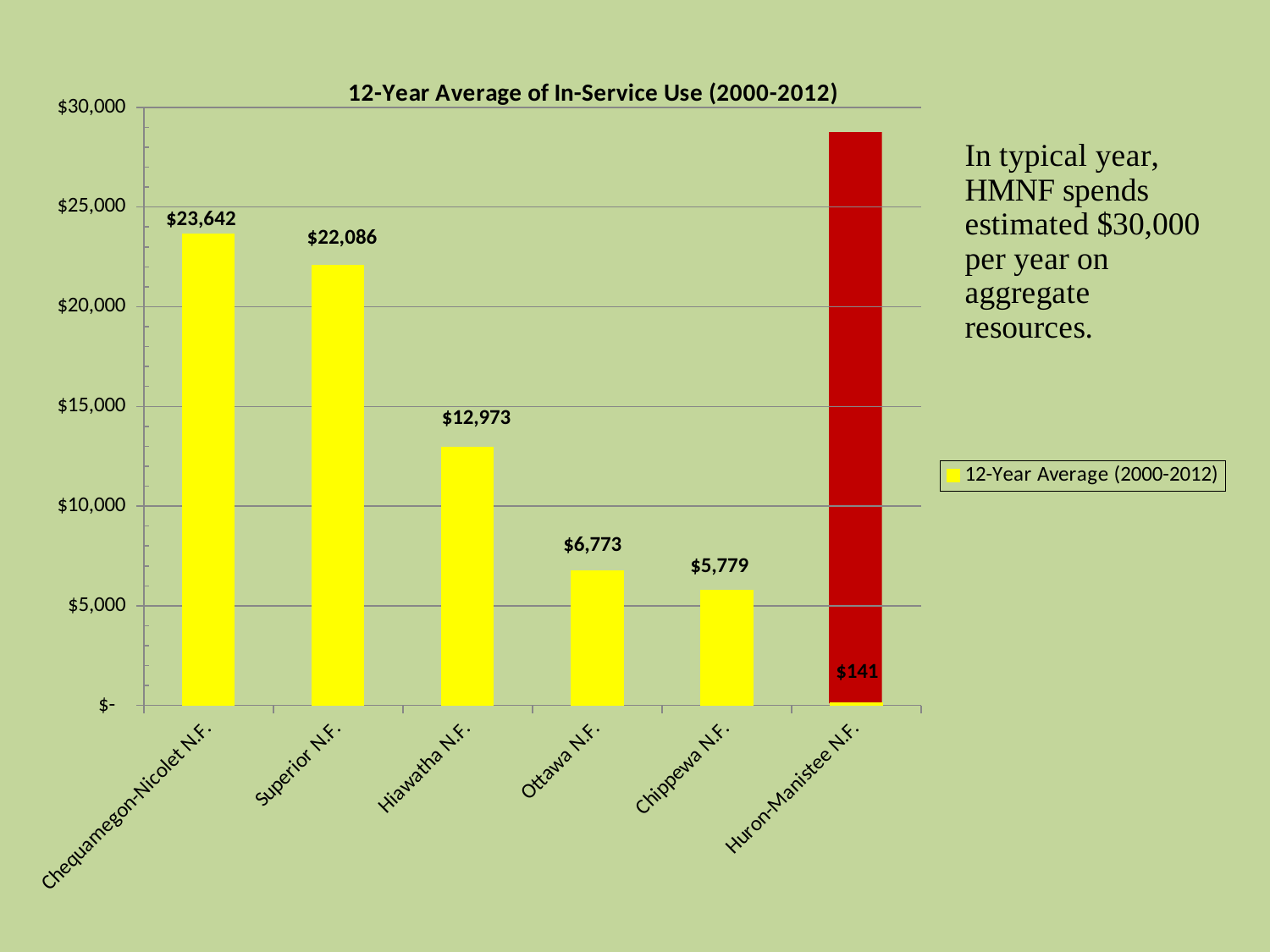
How many categories are shown on the x axis? 6 What is the value for Hiawatha N.F.? $12,973 What is the difference between the values for Chequamegon-Nicolet N.F. and Superior N.F.? $1,556 How many series does the legend list? 1 What is the difference between the values for Ottawa N.F. and Chippewa N.F.? $994 What is the value for Superior N.F.? $22,086 What is the value for Chequamegon-Nicolet N.F.? $23,642 Which has a larger value, Ottawa N.F. or Chippewa N.F.? Ottawa N.F. What is the title of the chart? 12-Year Average of In-Service Use (2000-2012) What is the data label shown for Huron-Manistee N.F.? $141 What kind of chart is shown? bar chart Is the value for Hiawatha N.F. greater or less than $10,000? greater